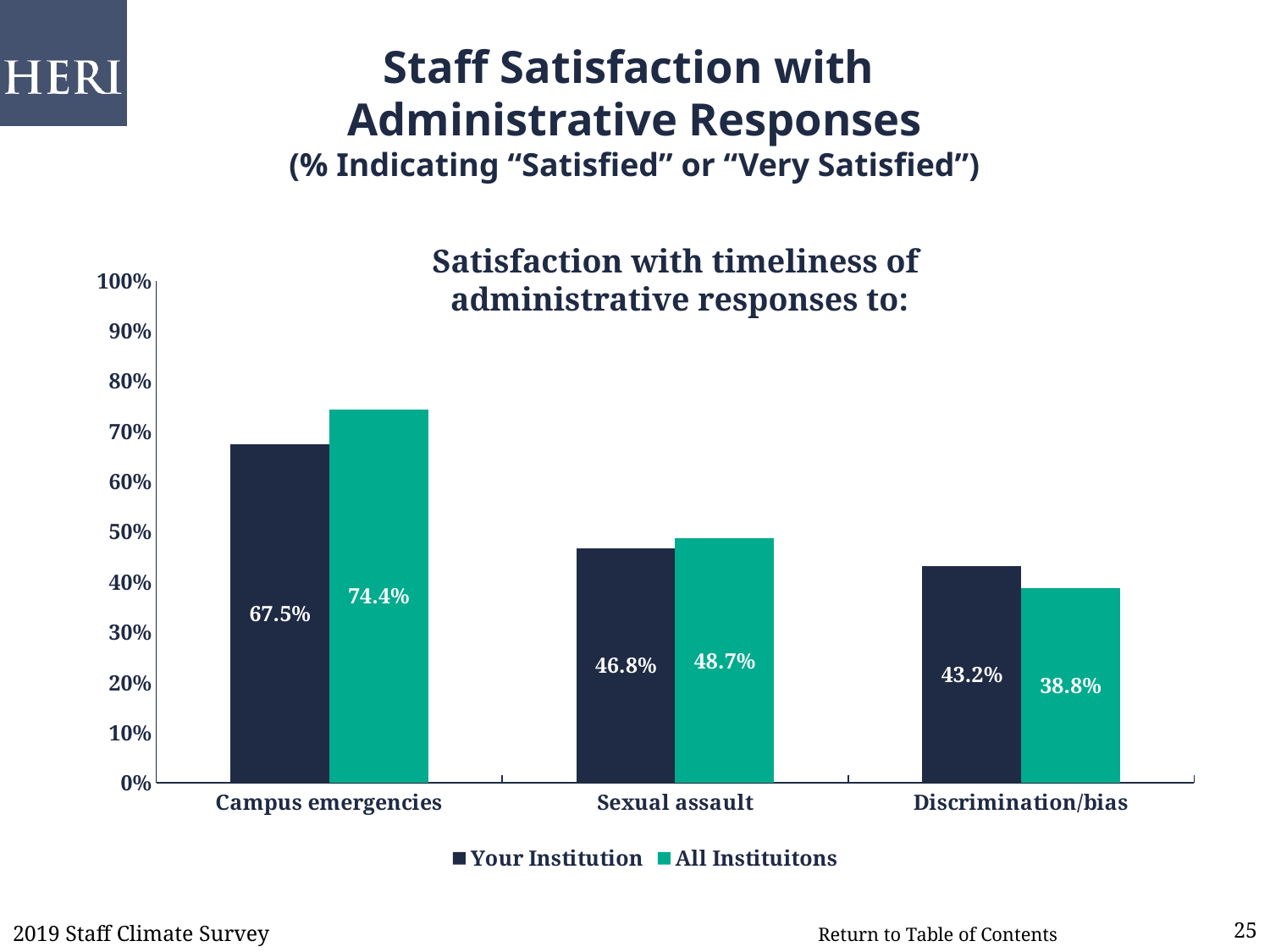
For Discrimination/bias, which is larger: Your Institution or All Instituitons? Your Institution What is the value for Your Institution for Sexual assault? 46.8% How many series does the legend list? 2 Which category has the highest value for All Instituitons? Campus emergencies What is the value for All Instituitons for Discrimination/bias? 38.8% What kind of chart is shown on the slide? bar chart How many categories are shown on the x axis? 3 What is the difference between All Instituitons and Your Institution for Campus emergencies? 6.9% What is the value for Your Institution for Campus emergencies? 67.5% Is the value for Your Institution for Campus emergencies greater or less than 60%? greater Which category has the lowest value for Your Institution? Discrimination/bias Do the values for Your Institution rise or fall from Campus emergencies to Discrimination/bias? fall